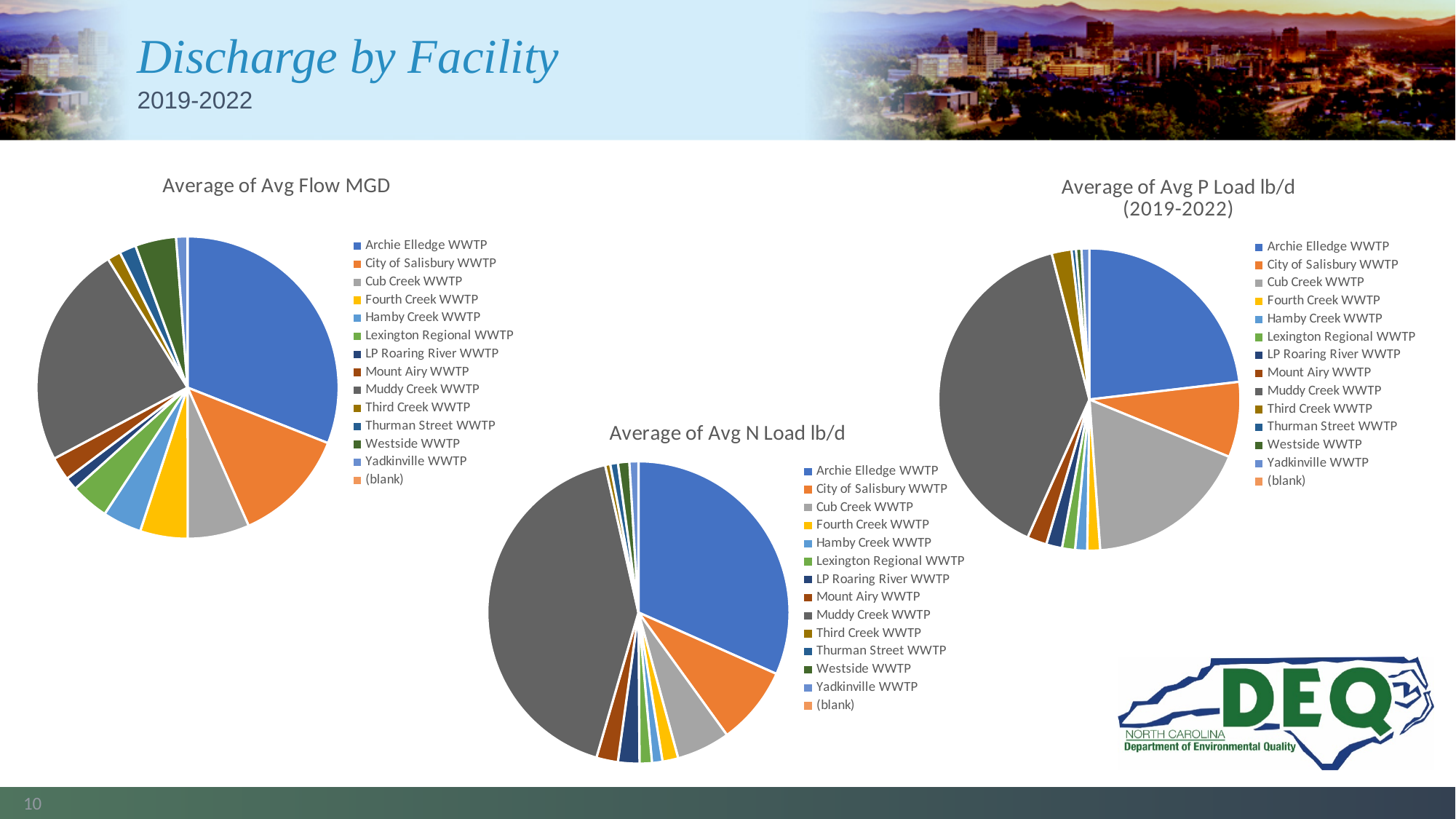
How many pie charts are shown on the slide? 3 In the "Average of Avg P Load lb/d (2019-2022)" chart, which facility has the largest slice? Muddy Creek WWTP In the "Average of Avg N Load lb/d" chart, which facility has the largest slice? Muddy Creek WWTP In the "Average of Avg Flow MGD" chart, which slice is larger: Archie Elledge WWTP or City of Salisbury WWTP? Archie Elledge WWTP In the "Average of Avg Flow MGD" chart, which slice is larger: Cub Creek WWTP or Fourth Creek WWTP? Cub Creek WWTP In the "Average of Avg P Load lb/d (2019-2022)" chart, which slice is larger: Muddy Creek WWTP or Archie Elledge WWTP? Muddy Creek WWTP In the "Average of Avg P Load lb/d (2019-2022)" chart, what colour represents Archie Elledge WWTP? blue How many entries does the legend of the "Average of Avg N Load lb/d" chart list? 14 What is the title of the middle chart on the slide? Average of Avg N Load lb/d What kind of chart is the "Average of Avg Flow MGD" chart? pie chart How many entries does the legend of the "Average of Avg Flow MGD" chart list? 14